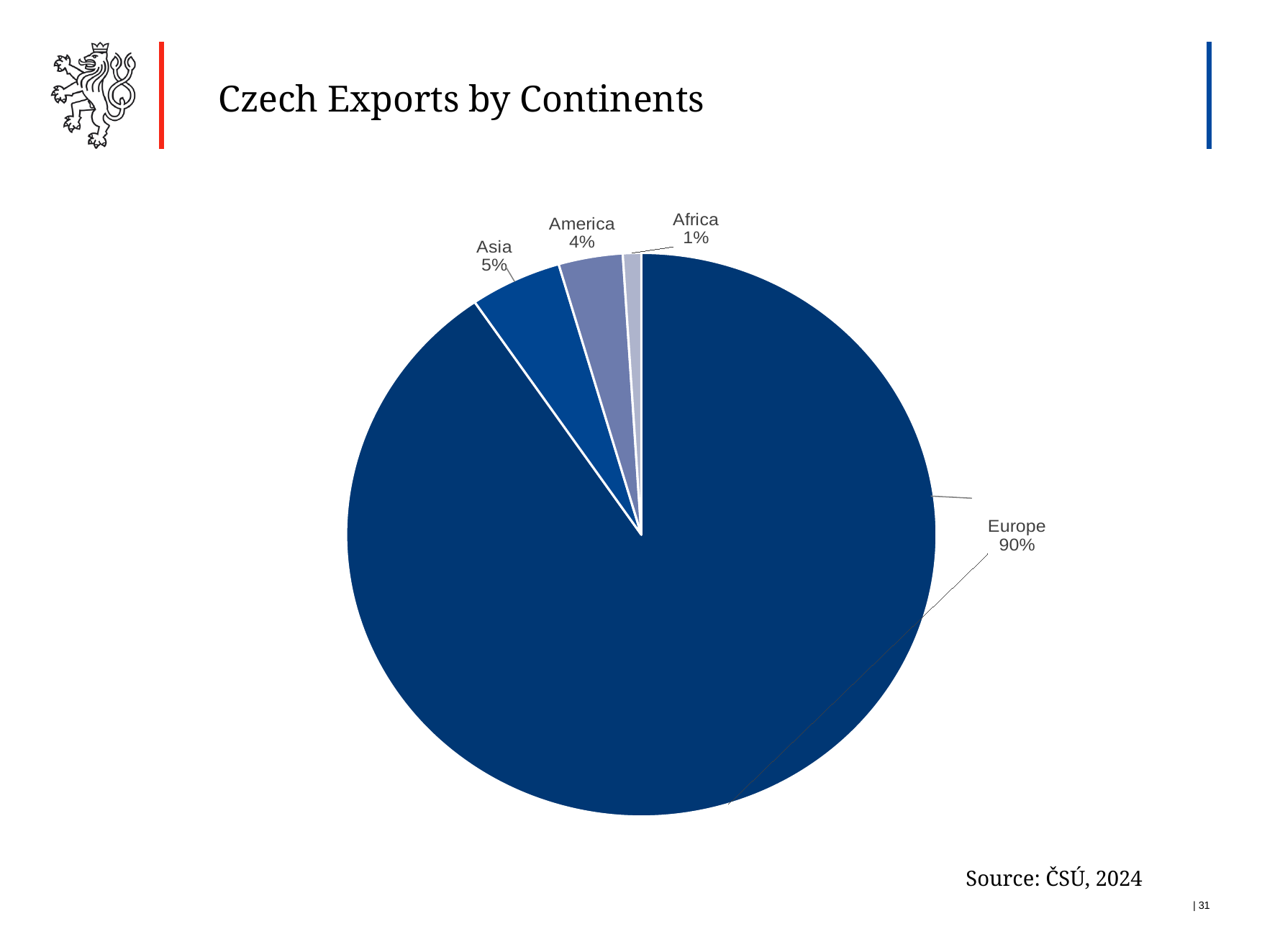
What share of Czech exports goes to Europe? 90% What is the difference in percentage points between the Europe and Asia shares? 85 What share of Czech exports goes to Africa? 1% How many continents are shown in the pie chart? 4 What is the difference in percentage points between the Asia and America shares? 1 What kind of chart is shown on the slide? Pie chart Which continent has the largest share of Czech exports? Europe What share of Czech exports goes to Asia? 5% Which has a larger share of Czech exports, Asia or America? Asia Which continent has the smallest share of Czech exports? Africa What is the title of the chart? Czech Exports by Continents